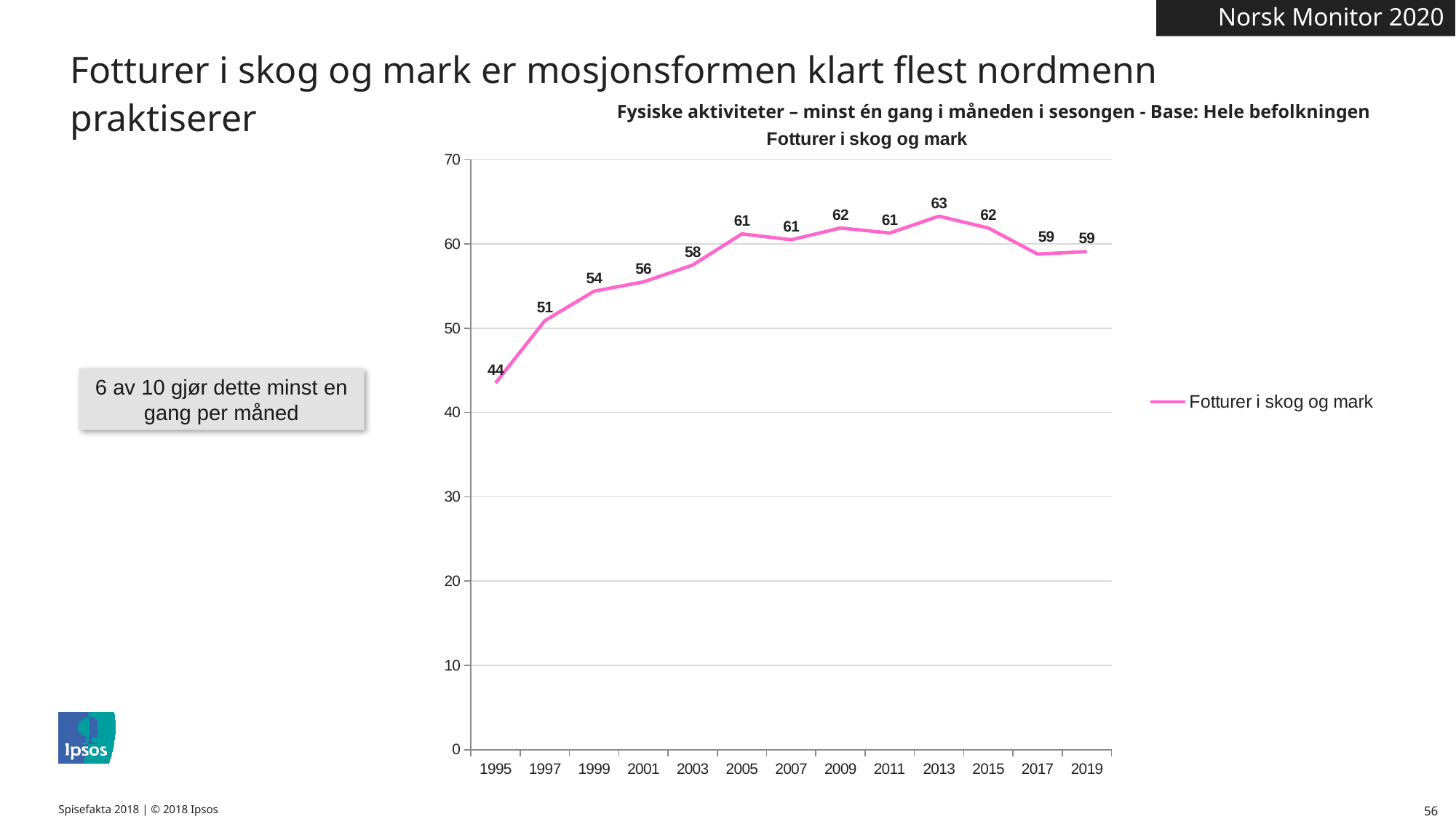
Which year has the lowest value? 1995 Which year has the highest value? 2013 Do the values rise or fall from 1995 to 2005? rise What value is shown for 1995? 44 What kind of chart is this? line chart Is the value for 2009 greater or less than 50? greater How many years are plotted on the x axis? 13 What is the difference between the values for 2013 and 1995? 19 How many series does the legend list? 1 What value is shown for 2019? 59 Which is larger, the value for 2005 or the value for 1999? 2005 What value is shown for 2013? 63